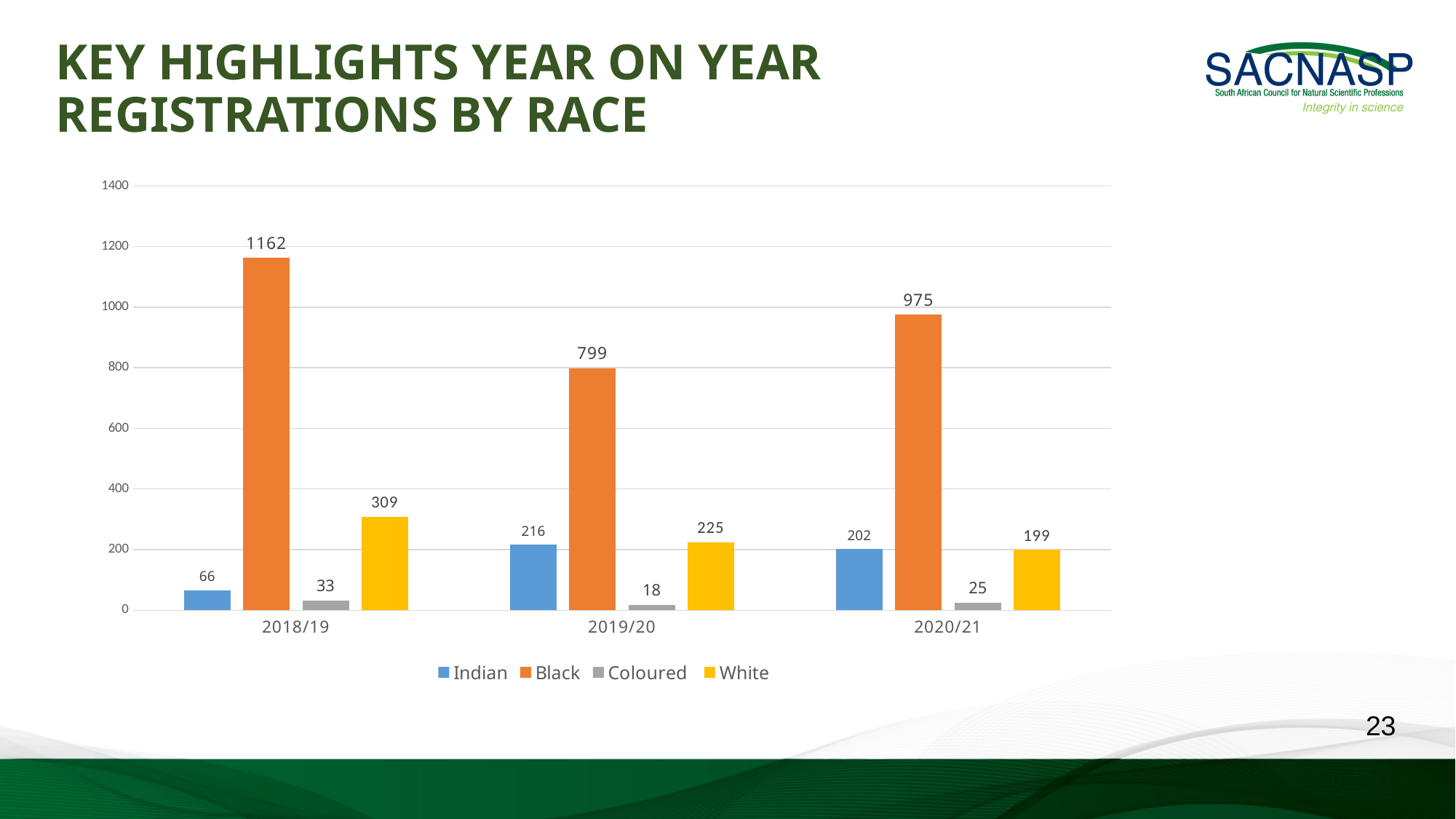
What is the value for White in 2018/19? 309 In which year is the Black series highest? 2018/19 What is the value for Black in 2018/19? 1162 In which year is the Coloured series lowest? 2019/20 What is the value for Coloured in 2020/21? 25 How many year categories are shown on the x axis? 3 What is the difference between the Black values for 2018/19 and 2019/20? 363 What kind of chart is shown on the slide? Bar chart Which is larger, the Indian value in 2019/20 or the Indian value in 2020/21? 2019/20 How many series does the legend list? 4 What is the value for Indian in 2019/20? 216 Does the White series rise or fall from 2018/19 to 2020/21? Fall